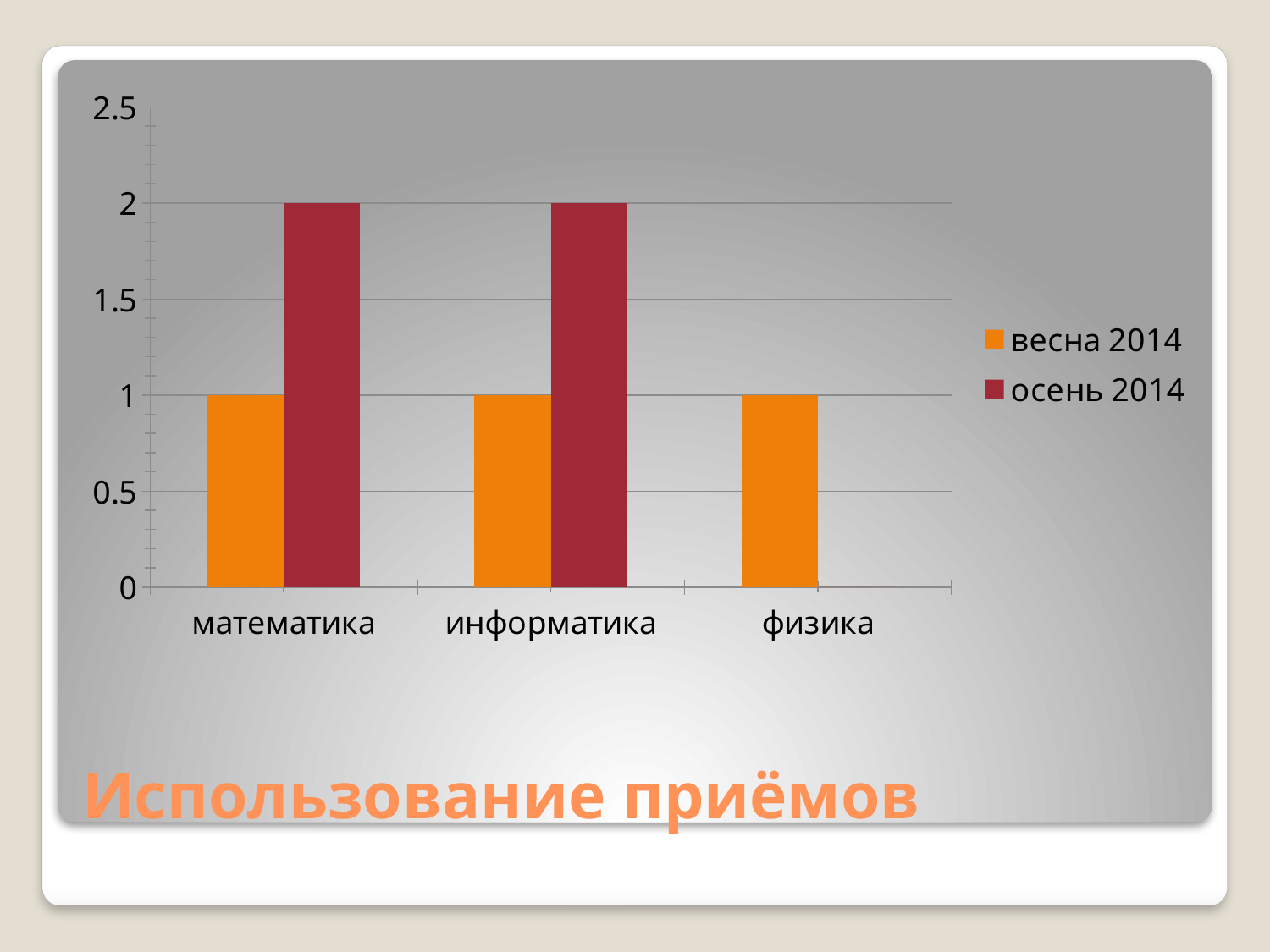
Which category has no bar for the осень 2014 series? физика What colour are the bars for the весна 2014 series? orange What is the value for информатика in the осень 2014 series? 2 What is the value for математика in the весна 2014 series? 1 What is the value for математика in the осень 2014 series? 2 What is the value for физика in the весна 2014 series? 1 How many series does the legend list? 2 What is the difference between the осень 2014 and весна 2014 values for математика? 1 What kind of chart is shown on the slide? bar chart Is the осень 2014 value for информатика greater or less than 1.5? greater Which is larger for информатика: the весна 2014 value or the осень 2014 value? осень 2014 How many categories are shown on the x axis? 3